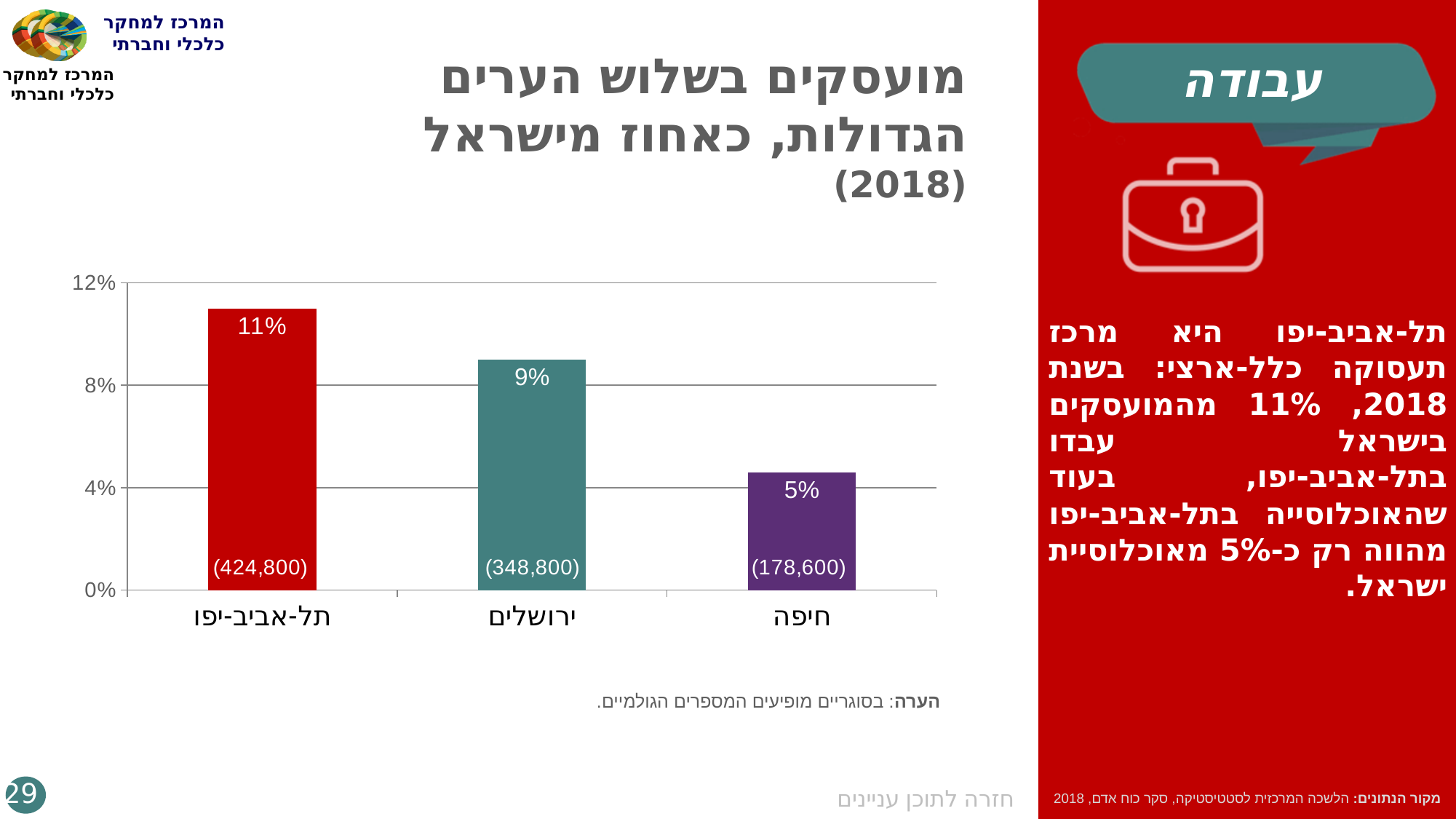
What is the difference in percentage points between תל-אביב-יפו and חיפה? 6% How many cities are shown in the chart? 3 What colour is the bar for תל-אביב-יפו? Red What percentage is shown for ירושלים? 9% What absolute number is printed in parentheses on the bar for חיפה? (178,600) Which is larger, the value for ירושלים or the value for חיפה? ירושלים Which city has the lowest share of employed persons? חיפה What type of chart is shown on the slide? Bar chart Which city has the highest share of employed persons? תל-אביב-יפו What absolute number is printed in parentheses on the bar for ירושלים? (348,800) What percentage is shown for חיפה? 5% What percentage is shown for תל-אביב-יפו? 11%